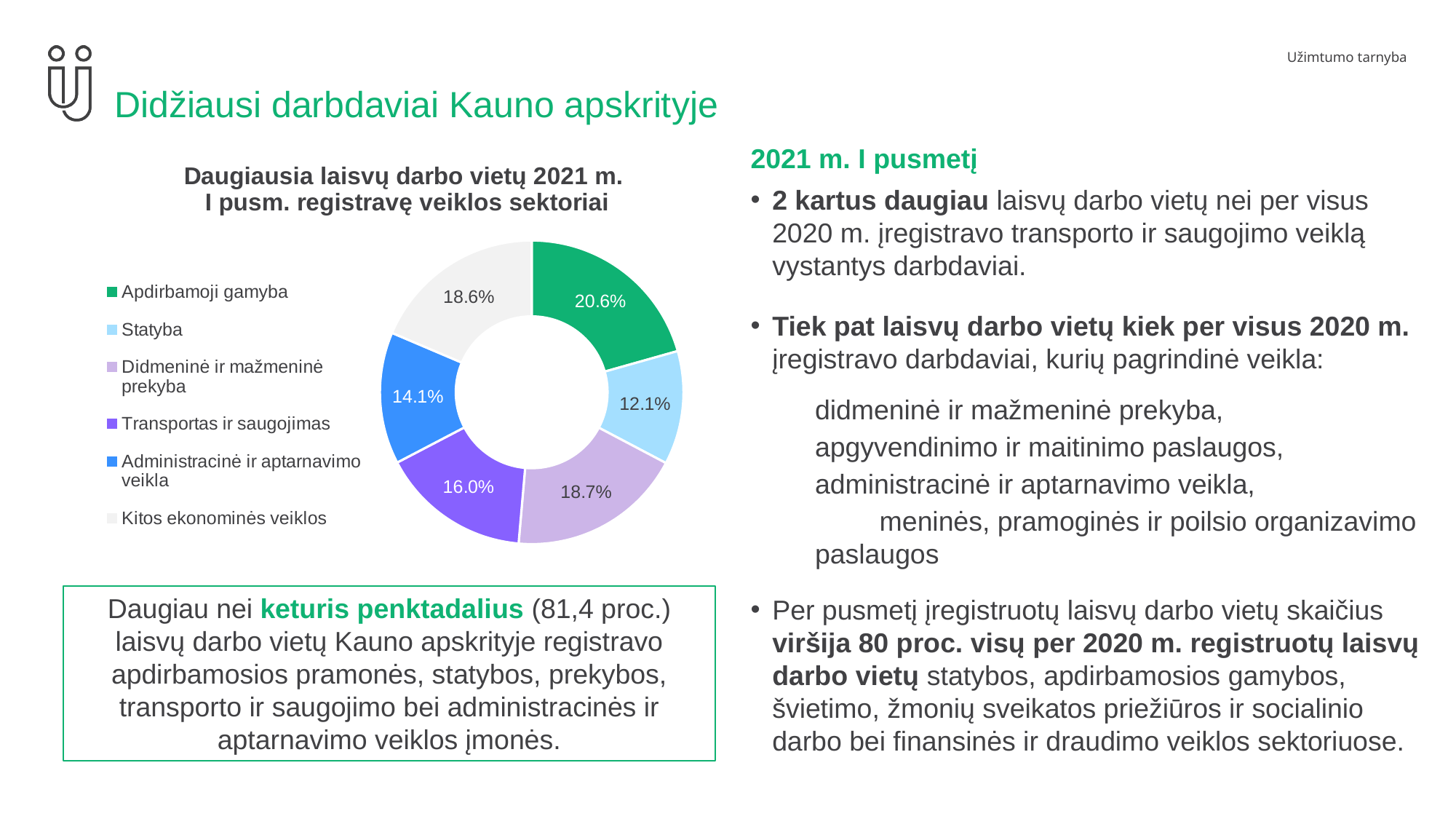
What is the value for Didmeninė ir mažmeninė prekyba? 18.7% What is the value shown for Statyba? 12.1% Which sector has the largest share in the chart? Apdirbamoji gamyba What share is labelled for Kitos ekonominės veiklos? 18.6% What is the value for Administracinė ir aptarnavimo veikla? 14.1% What type of chart is shown on the slide? Doughnut (pie) chart What share of the chart does Apdirbamoji gamyba have? 20.6% What percentage is shown for Transportas ir saugojimas? 16.0% Which sector has the smallest share in the chart? Statyba What is the difference in percentage points between Apdirbamoji gamyba and Statyba? 8.5 Which is larger, the share for Transportas ir saugojimas or the share for Administracinė ir aptarnavimo veikla? Transportas ir saugojimas How many sectors are shown in the chart? 6